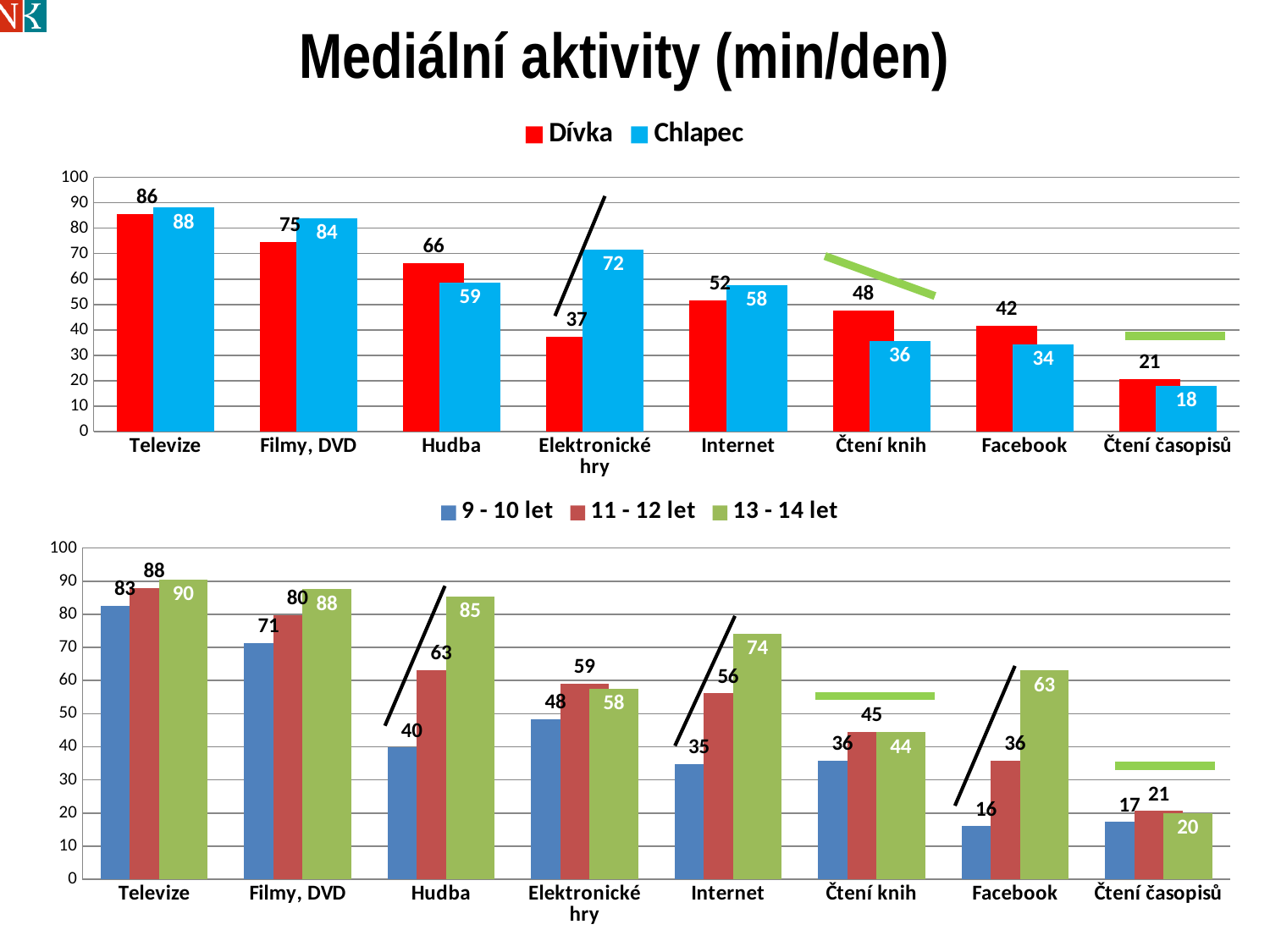
In the bottom chart (age groups), which category has the lowest 9 - 10 let value? Facebook How many series does the legend of the bottom chart list? 3 In the top chart (Dívka / Chlapec), which category has the highest Dívka value? Televize In the top chart (Dívka / Chlapec), what is the value for Dívka for Čtení knih? 48 How many categories are shown on the x axis of the top chart? 8 In the bottom chart (age groups), what is the value for 9 - 10 let for Internet? 35 In the top chart (Dívka / Chlapec), which is larger for Hudba: Dívka or Chlapec? Dívka In the top chart (Dívka / Chlapec), what is the difference between the Chlapec and Dívka values for Elektronické hry? 35 In the bottom chart (age groups), what is the value for 13 - 14 let for Facebook? 63 In the bottom chart (age groups), what is the difference between the 13 - 14 let and 9 - 10 let values for Hudba? 45 In the top chart (Dívka / Chlapec), which category has the lowest Chlapec value? Čtení časopisů In the top chart (Dívka / Chlapec), what is the value for Chlapec for Elektronické hry? 72